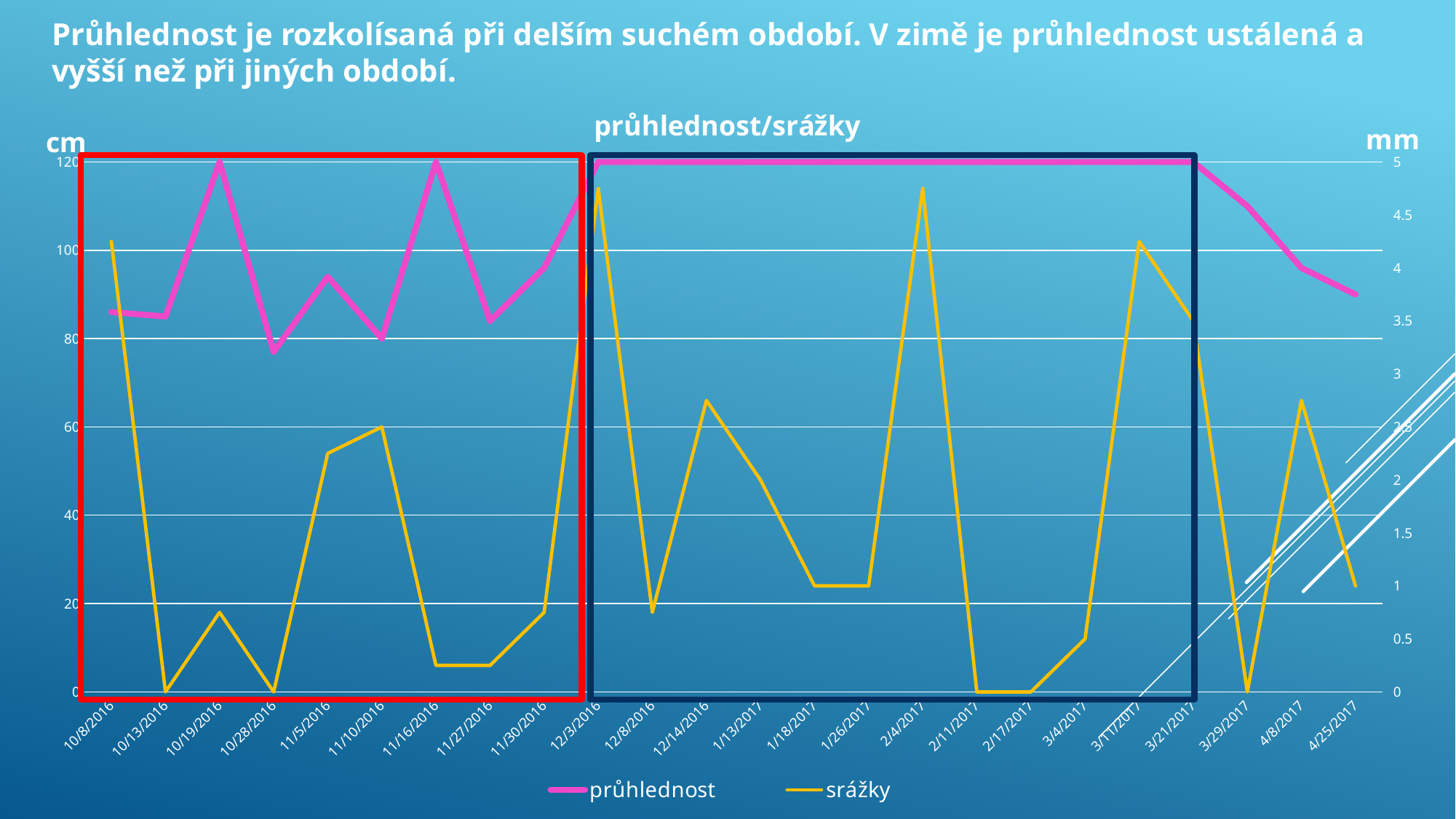
What is the value of srážky on 10/13/2016? 0 Is the value of srážky on 12/3/2016 greater or less than 4.5? greater What kind of chart is shown on the slide? line chart What is the value of průhlednost on 11/10/2016? 80 How many dates are plotted along the x axis? 24 What is the value of srážky on 11/10/2016? 2.5 What is the value of průhlednost on 10/19/2016? 120 Which series is drawn in pink? průhlednost What is the title of the chart? průhlednost/srážky How many series does the legend list? 2 Is the value of průhlednost on 10/28/2016 greater or less than 80? less Which date has the larger srážky value, 10/8/2016 or 10/13/2016? 10/8/2016